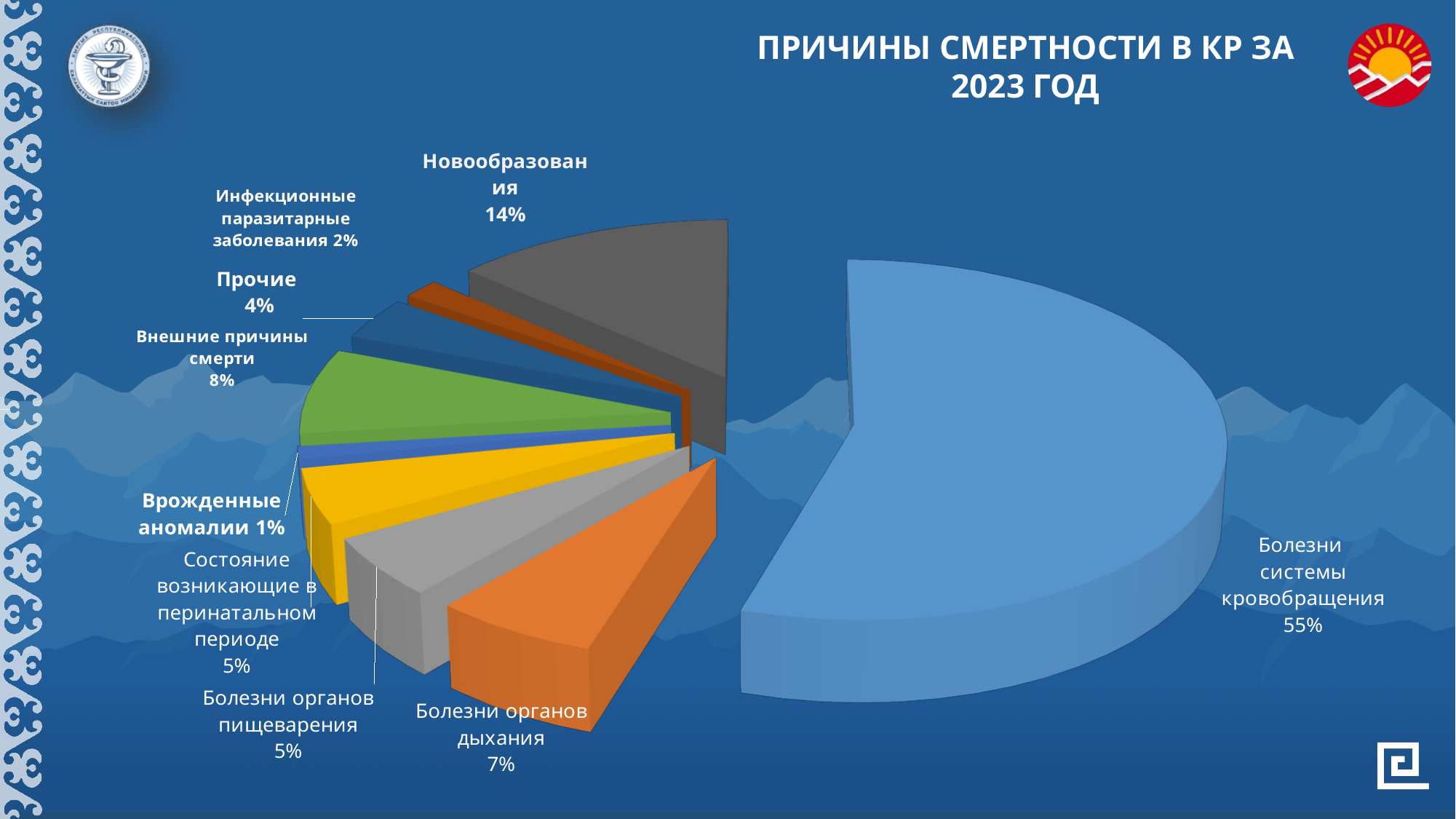
Which cause of death has the smallest share in the pie chart? Врожденные аномалии Which cause of death has the largest share in the pie chart? Болезни системы кровообращения What percentage is shown for Новообразования? 14% What percentage is shown for Внешние причины смерти? 8% What percentage is shown for Инфекционные паразитарные заболевания? 2% What share of deaths is attributed to Болезни системы кровообращения? 55% How many categories (slices) does the pie chart have? 9 Which is larger: the share for Внешние причины смерти or the share for Прочие? Внешние причины смерти What percentage is shown for Болезни органов дыхания? 7% What is the title of the chart? ПРИЧИНЫ СМЕРТНОСТИ В КР ЗА 2023 ГОД What is the difference in percentage points between Болезни системы кровообращения and Новообразования? 41 What type of chart is shown on the slide? Pie chart